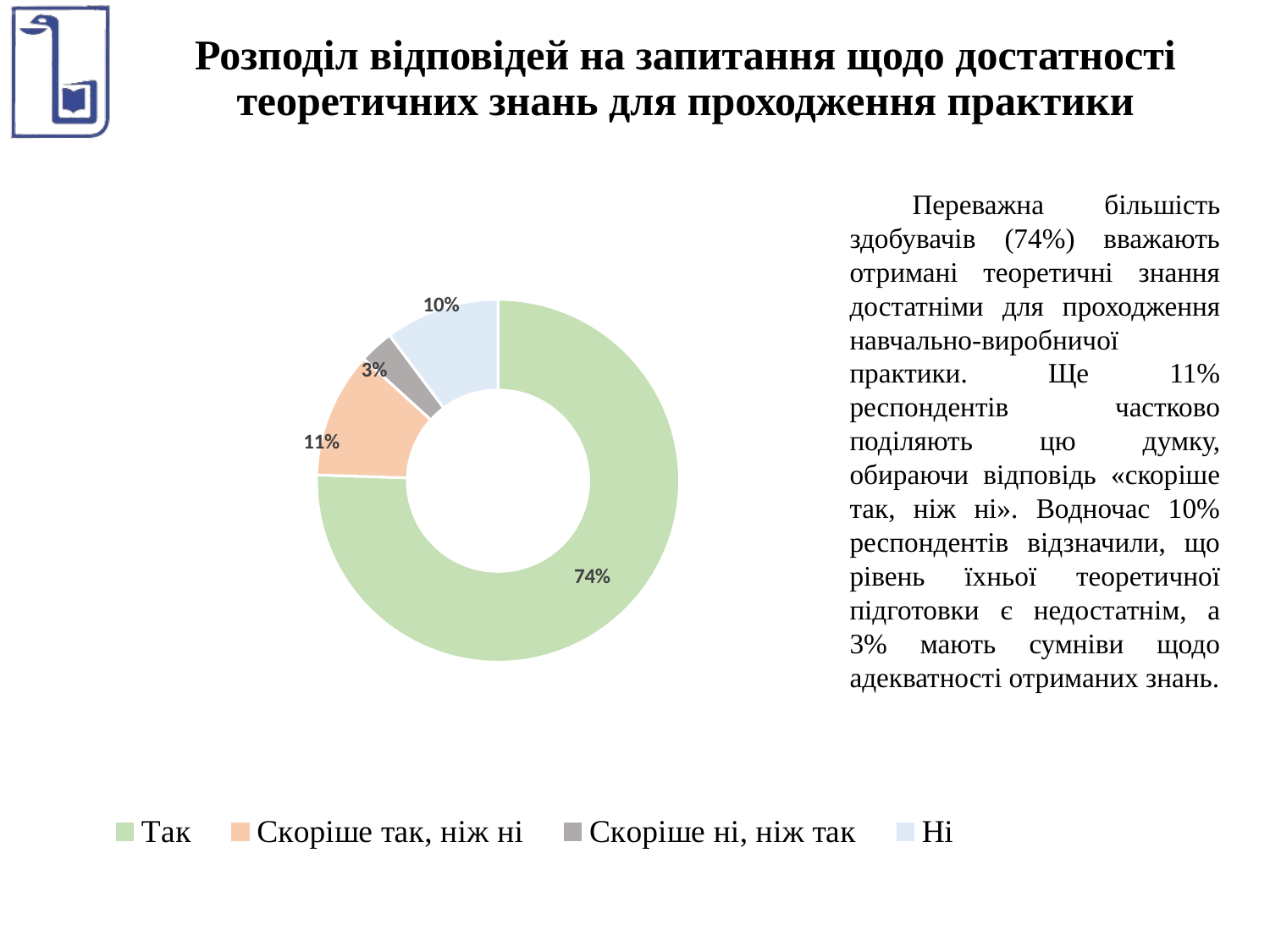
Which answer option has the smallest share of the chart? Скоріше ні, ніж так Which is larger: the share for "Скоріше так, ніж ні" or the share for "Ні"? Скоріше так, ніж ні What is the difference in percentage points between "Так" and "Ні"? 64 What percentage of respondents answered "Скоріше так, ніж ні"? 11% What percentage of respondents answered "Скоріше ні, ніж так"? 3% What kind of chart is shown on the slide? Doughnut (pie) chart What percentage of respondents answered "Так"? 74% How many entries does the legend list? 4 What colour is the slice for "Так"? Green Which answer option has the largest share of the chart? Так How many answer options are shown in the chart? 4 What percentage of respondents answered "Ні"? 10%